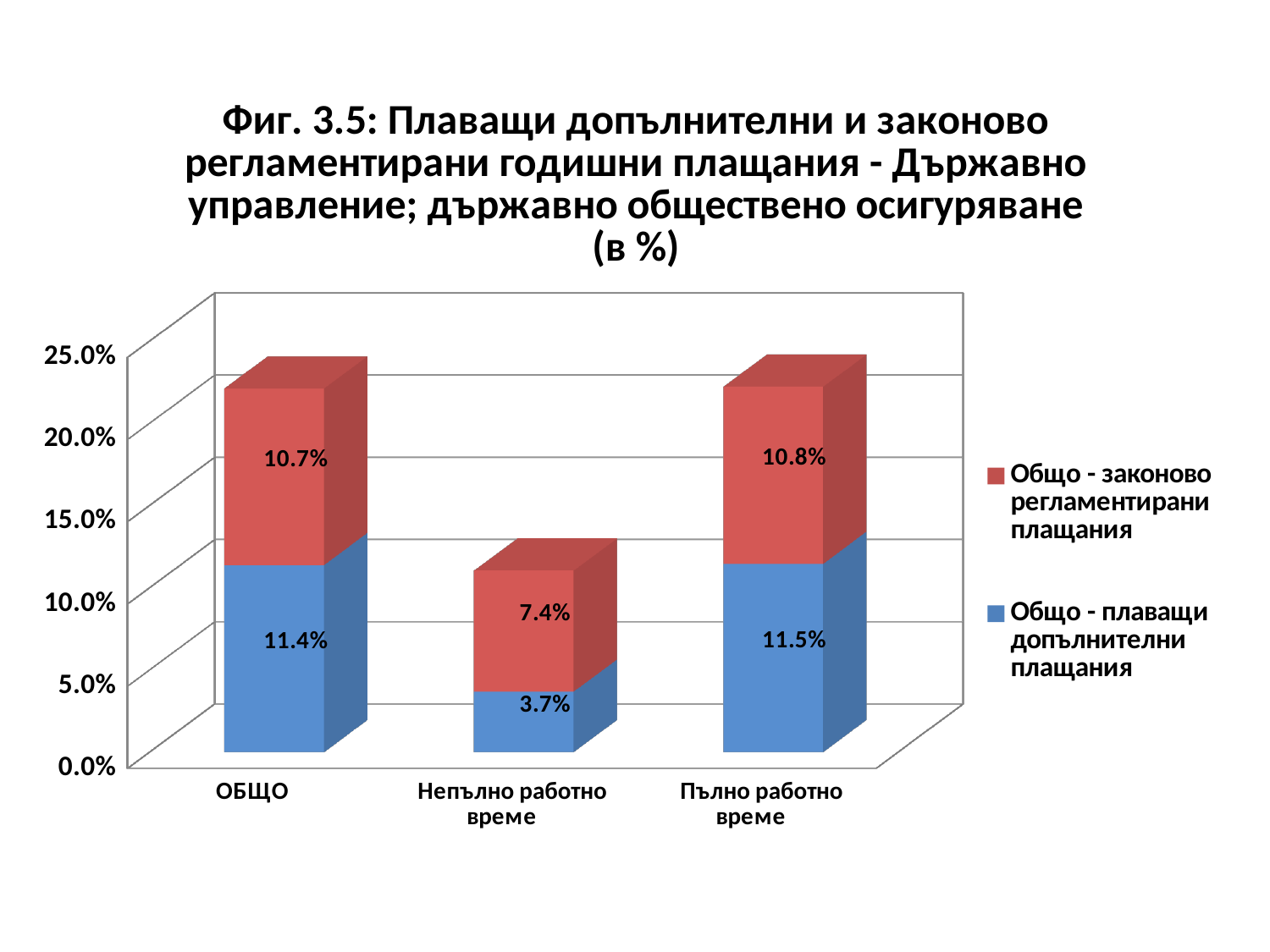
What is the value of 'Общо - законово регламентирани плащания' for 'Пълно работно време'? 10.8% What is the total of the stacked bar for 'ОБЩО'? 22.1% How many categories are shown on the x axis? 3 What is the value of 'Общо - плаващи допълнителни плащания' for 'Непълно работно време'? 3.7% What is the difference between the 'Общо - плаващи допълнителни плащания' values for 'Пълно работно време' and 'Непълно работно време'? 7.8% How many series does the legend list? 2 Which category has the lowest value for 'Общо - законово регламентирани плащания'? Непълно работно време What is the value of 'Общо - плаващи допълнителни плащания' for 'ОБЩО'? 11.4% What type of chart is shown on the slide? Stacked bar chart For 'Непълно работно време', which is larger: 'Общо - законово регламентирани плащания' or 'Общо - плаващи допълнителни плащания'? Общо - законово регламентирани плащания What is the total of the stacked bar for 'Непълно работно време'? 11.1% Which colour represents 'Общо - плаващи допълнителни плащания' in the chart? Blue